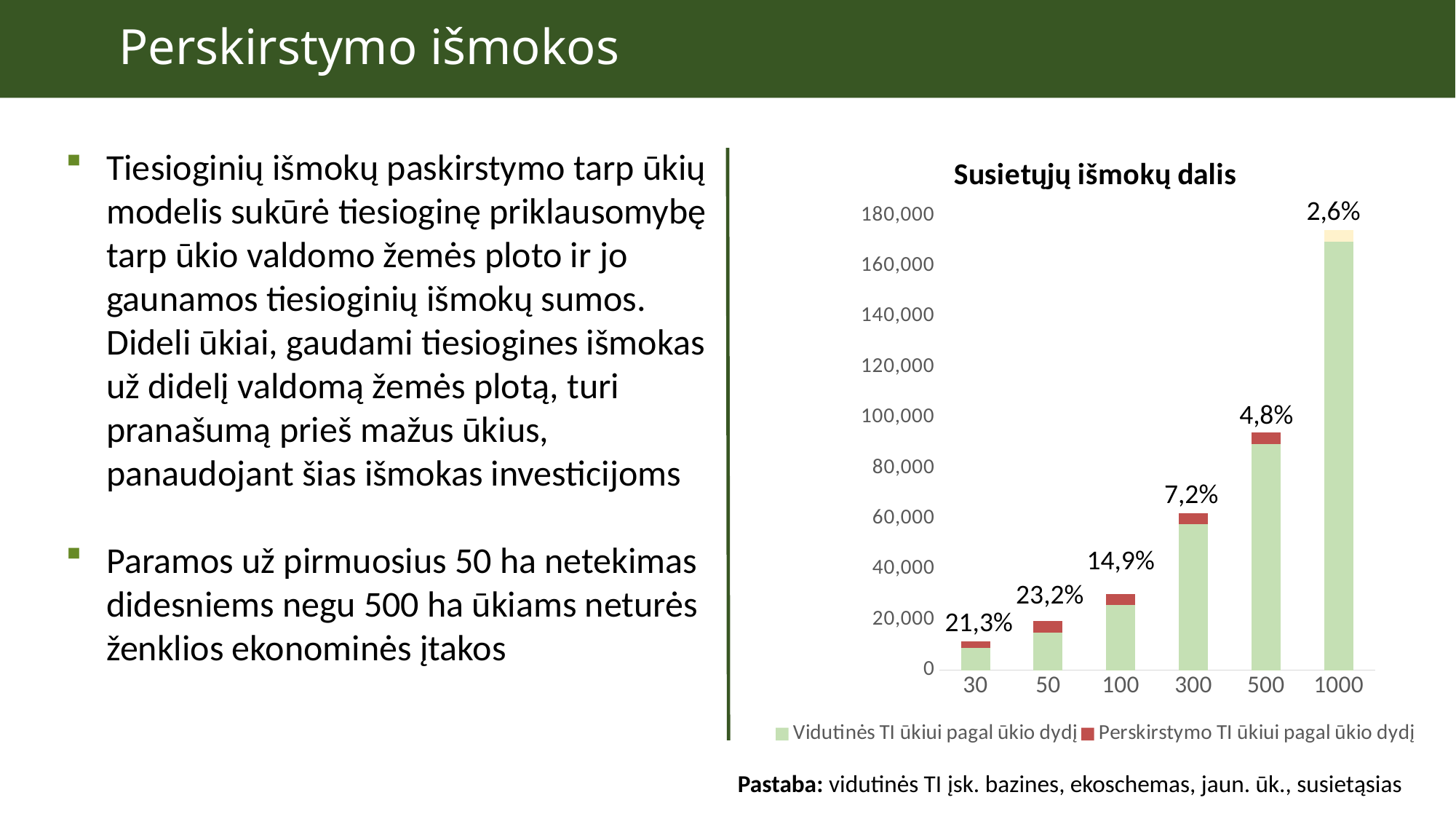
Is the total height of the bar for category 1000 greater or less than 160,000? greater How many series does the chart legend list? 2 Which category has the highest percentage label? 50 What percentage label is shown above the bar for category 1000? 2,6% What percentage label is shown above the bar for category 300? 7,2% Is the total height of the bar for category 30 greater or less than 20,000? less What is the title of the chart? Susietųjų išmokų dalis Which category has the lowest percentage label? 1000 What is the difference between the percentage labels for categories 50 and 30? 1,9% What percentage label is shown above the bar for category 50? 23,2% What type of chart is shown on the slide? stacked bar chart How many categories are shown on the x axis of the chart? 6